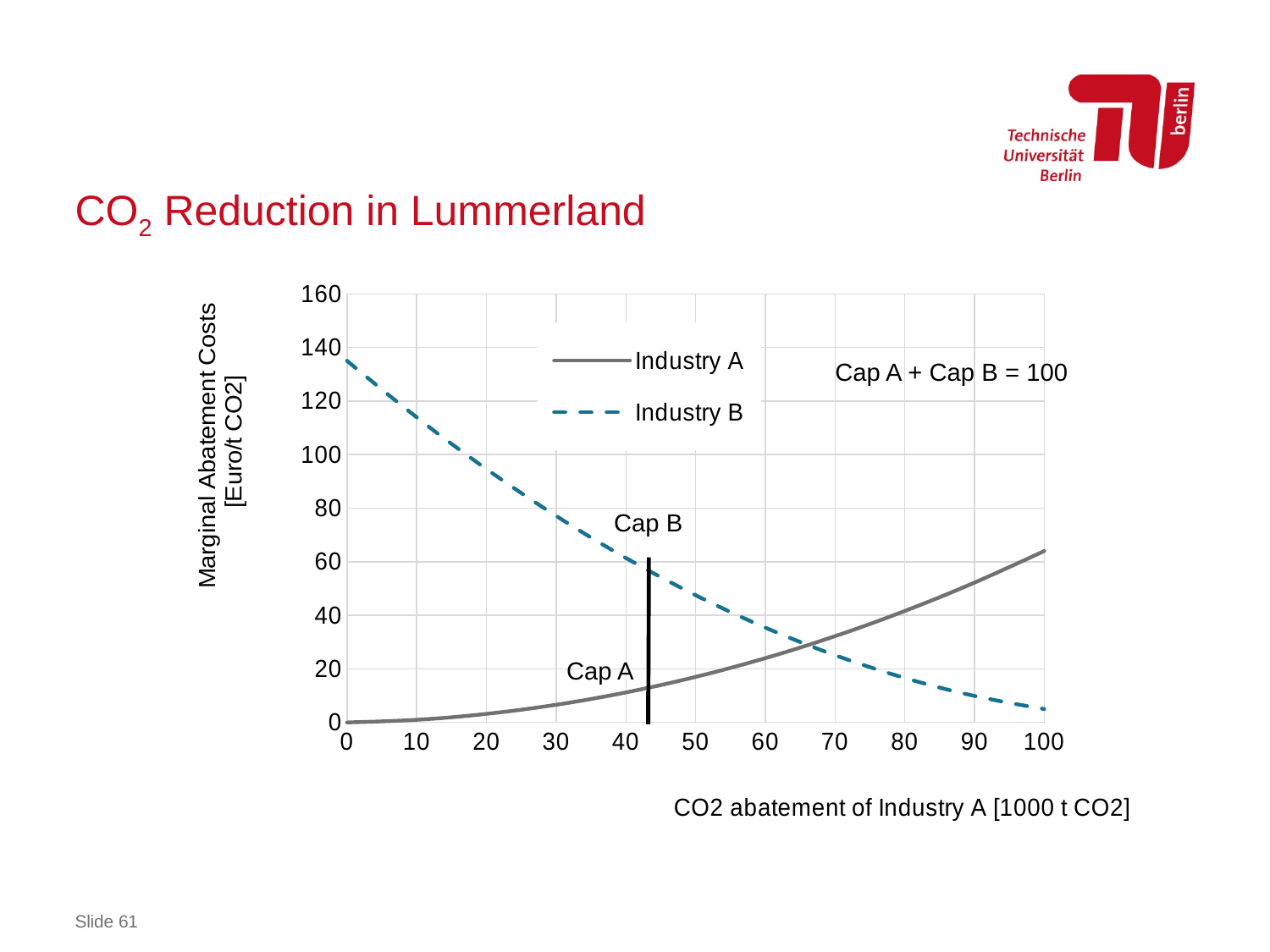
Does the Industry A line rise or fall as CO2 abatement of Industry A increases along the x axis? rise Is the value of Industry B at a CO2 abatement of 0 greater or less than 120? greater What kind of chart is shown on the slide? line chart Is the value of Industry A at a CO2 abatement of 50 greater or less than 40? less What equation is written as an annotation on the chart? Cap A + Cap B = 100 At a CO2 abatement of 20, which series has the higher marginal abatement cost, Industry A or Industry B? Industry B Does the Industry B line rise or fall as CO2 abatement of Industry A increases along the x axis? fall At a CO2 abatement of 90, which series has the higher marginal abatement cost, Industry A or Industry B? Industry A Is the value of Industry A at a CO2 abatement of 100 greater or less than 40? greater How many series does the chart legend list? 2 Which two series are listed in the chart legend? Industry A and Industry B